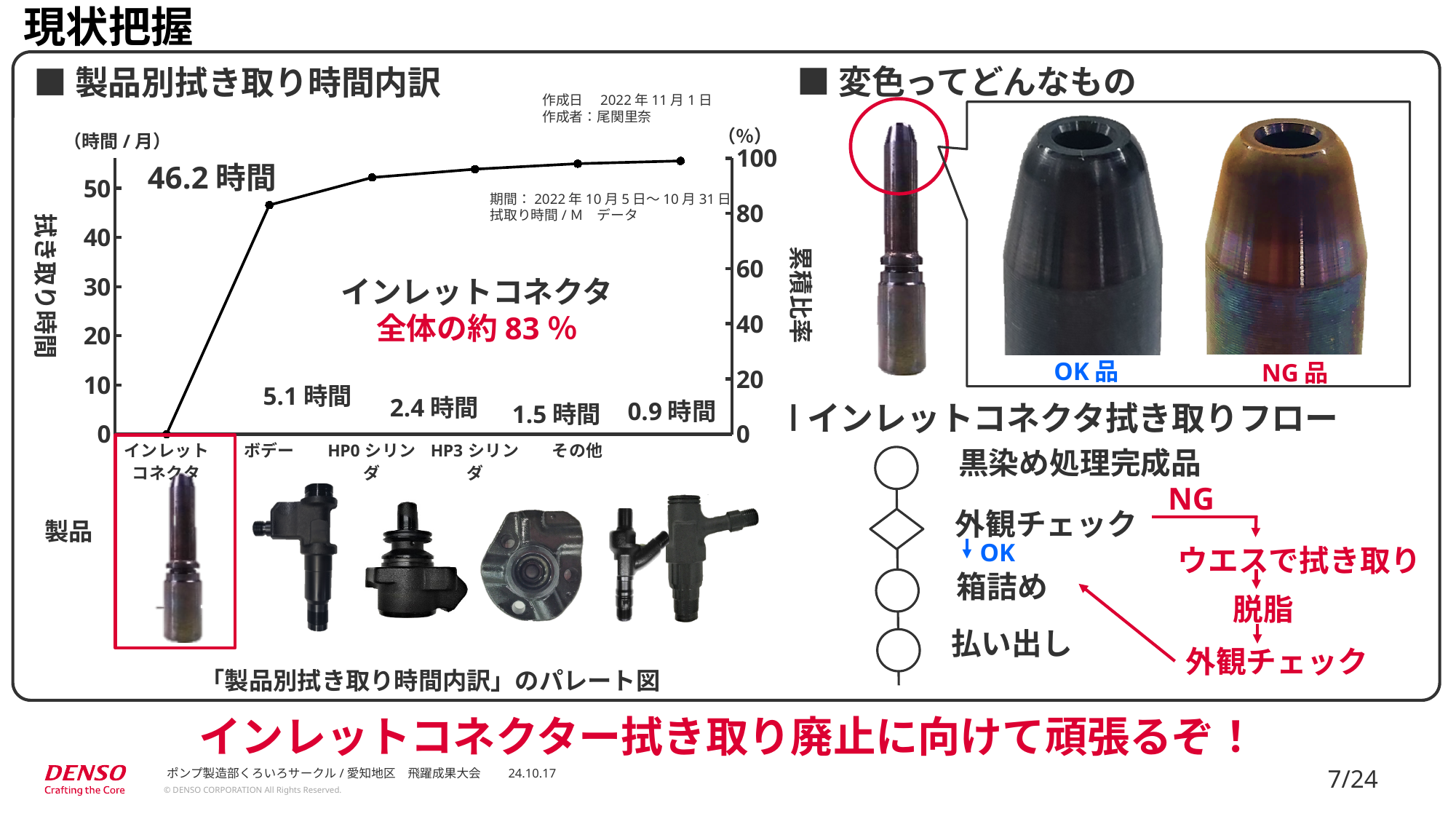
How many product categories are shown on the x axis of the 製品別拭き取り時間内訳 chart? 5 In the 製品別拭き取り時間内訳 chart, what is the difference between the values for インレットコネクタ and ボデー? 41.1 時間 In the 製品別拭き取り時間内訳 chart, which category has the lowest wiping time? その他 In the 製品別拭き取り時間内訳 chart, which product has the highest wiping time? インレットコネクタ According to the 製品別拭き取り時間内訳 chart, what share of the total does インレットコネクタ account for? 約 83 % In the 製品別拭き取り時間内訳 chart, which is larger, the value for HP0シリンダ or HP3シリンダ? HP0シリンダ In the 製品別拭き取り時間内訳 chart, what is the value for ボデー? 5.1 時間 In the 製品別拭き取り時間内訳 chart, do the wiping-time values rise or fall from left to right along the x axis? fall In the 製品別拭き取り時間内訳 chart, is the cumulative ratio (累積比率) at ボデー greater or less than 80%? greater What unit is shown at the top of the left axis of the 製品別拭き取り時間内訳 chart? 時間 / 月 In the 製品別拭き取り時間内訳 chart, what is the value for インレットコネクタ? 46.2 時間 In the 製品別拭き取り時間内訳 chart, what is the value for HP3シリンダ? 1.5 時間